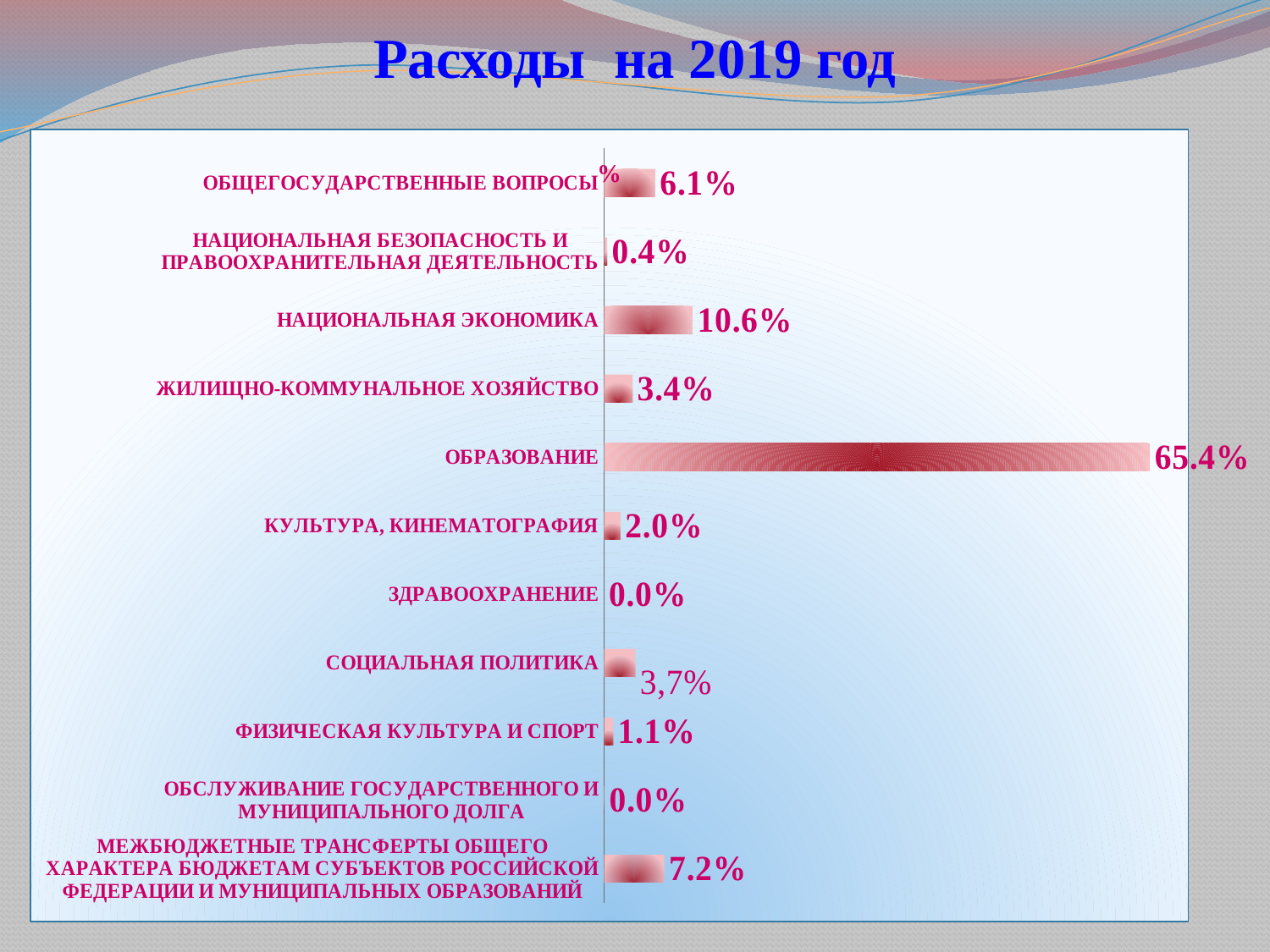
What is the value for НАЦИОНАЛЬНАЯ ЭКОНОМИКА? 10.6% What is the title of the chart? Расходы на 2019 год Which is larger, the value for ЖИЛИЩНО-КОММУНАЛЬНОЕ ХОЗЯЙСТВО or the value for КУЛЬТУРА, КИНЕМАТОГРАФИЯ? ЖИЛИЩНО-КОММУНАЛЬНОЕ ХОЗЯЙСТВО What type of chart is shown on the slide? bar chart Which category has the highest value? ОБРАЗОВАНИЕ What is the value for ОБРАЗОВАНИЕ? 65.4% What is the difference between the values for НАЦИОНАЛЬНАЯ ЭКОНОМИКА and ОБЩЕГОСУДАРСТВЕННЫЕ ВОПРОСЫ? 4.5% What is the value for ФИЗИЧЕСКАЯ КУЛЬТУРА И СПОРТ? 1.1% What is the value for СОЦИАЛЬНАЯ ПОЛИТИКА? 3,7% How many categories have a value of 0.0%? 2 What is the difference between the values for ОБРАЗОВАНИЕ and НАЦИОНАЛЬНАЯ ЭКОНОМИКА? 54.8% How many categories are shown in the chart? 11